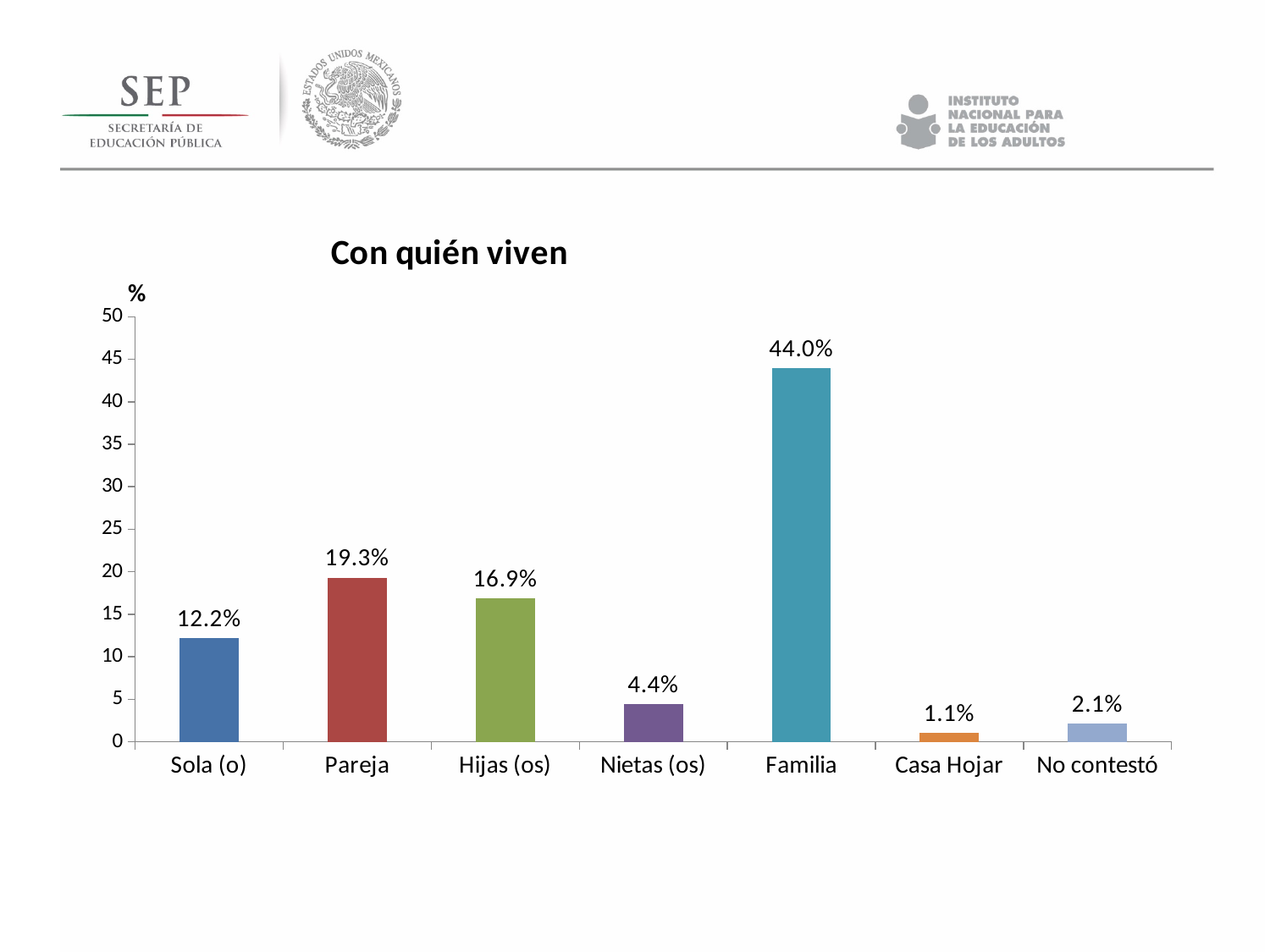
How many categories are shown on the x axis? 7 What is the difference between the values for Pareja and Hijas (os)? 2.4% What is the title of the chart? Con quién viven What is the value for Pareja? 19.3% Which is larger, the value for Sola (o) or the value for Nietas (os)? Sola (o) Which category has the lowest value? Casa Hojar What kind of chart is shown on the slide? bar chart What is the value for Casa Hojar? 1.1% What is the value for Familia? 44.0% What is the value for No contestó? 2.1% Which category has the highest value? Familia Is the value for Familia greater or less than 40? greater